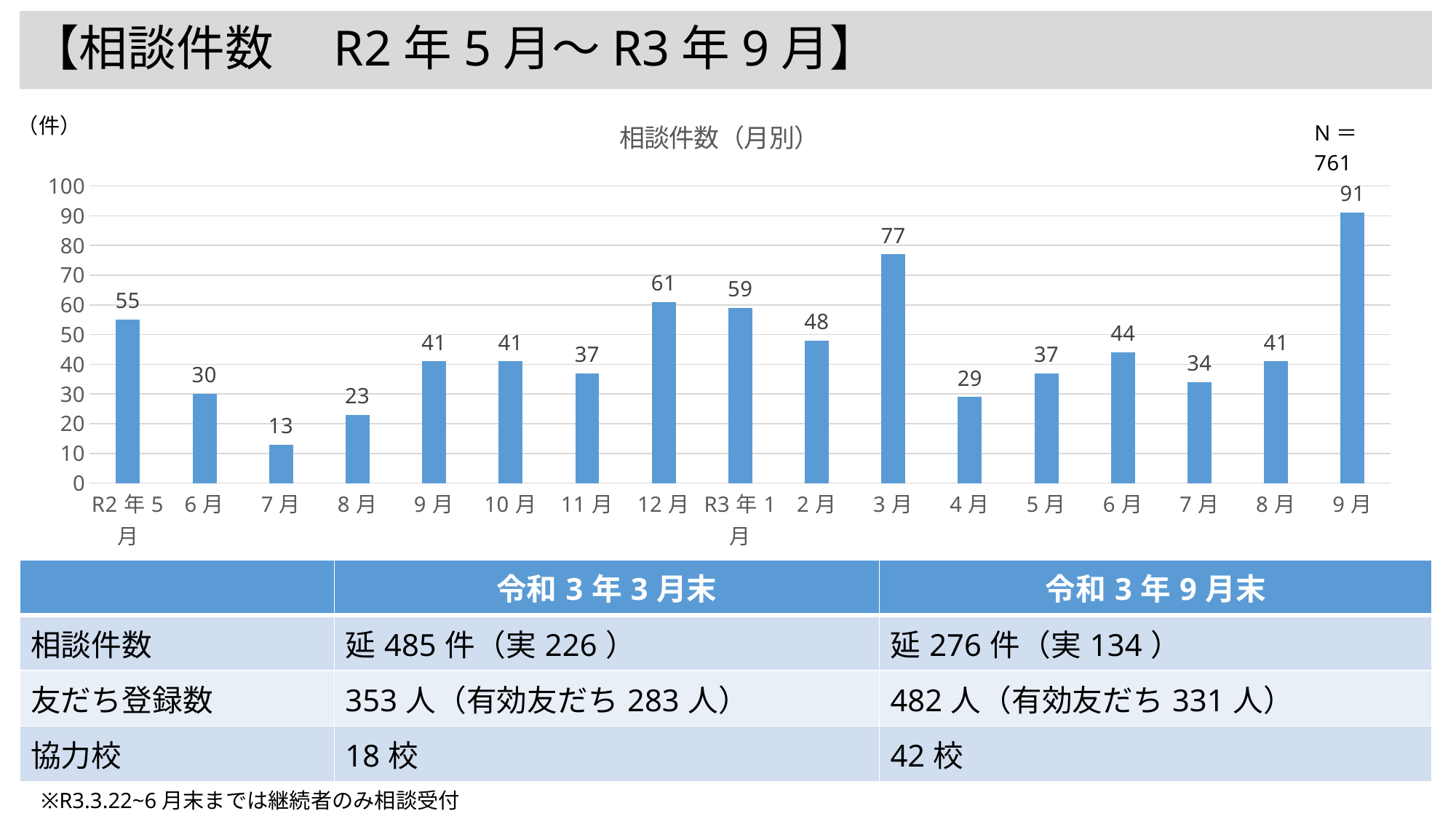
What is the difference between the values for R3年3月 and R3年4月 in the 相談件数（月別） chart? 48 Which is larger in the 相談件数（月別） chart, the value for R2年12月 or R3年1月? R2年12月 What is the value for R2年12月 in the 相談件数（月別） chart? 61 What is the difference between the values for R3年9月 and R3年8月 in the 相談件数（月別） chart? 50 How many months (bars) are shown in the 相談件数（月別） chart? 17 Which month has the lowest value in the 相談件数（月別） chart? R2年7月 Which month has the highest value in the 相談件数（月別） chart? R3年9月 What is the N value shown at the top right of the 相談件数（月別） chart? N＝761 Is the value for R3年2月 greater or less than 40 in the 相談件数（月別） chart? greater What kind of chart is the 相談件数（月別） chart? bar chart What is the value for R2年5月 in the 相談件数（月別） chart? 55 What is the value for R3年3月 in the 相談件数（月別） chart? 77